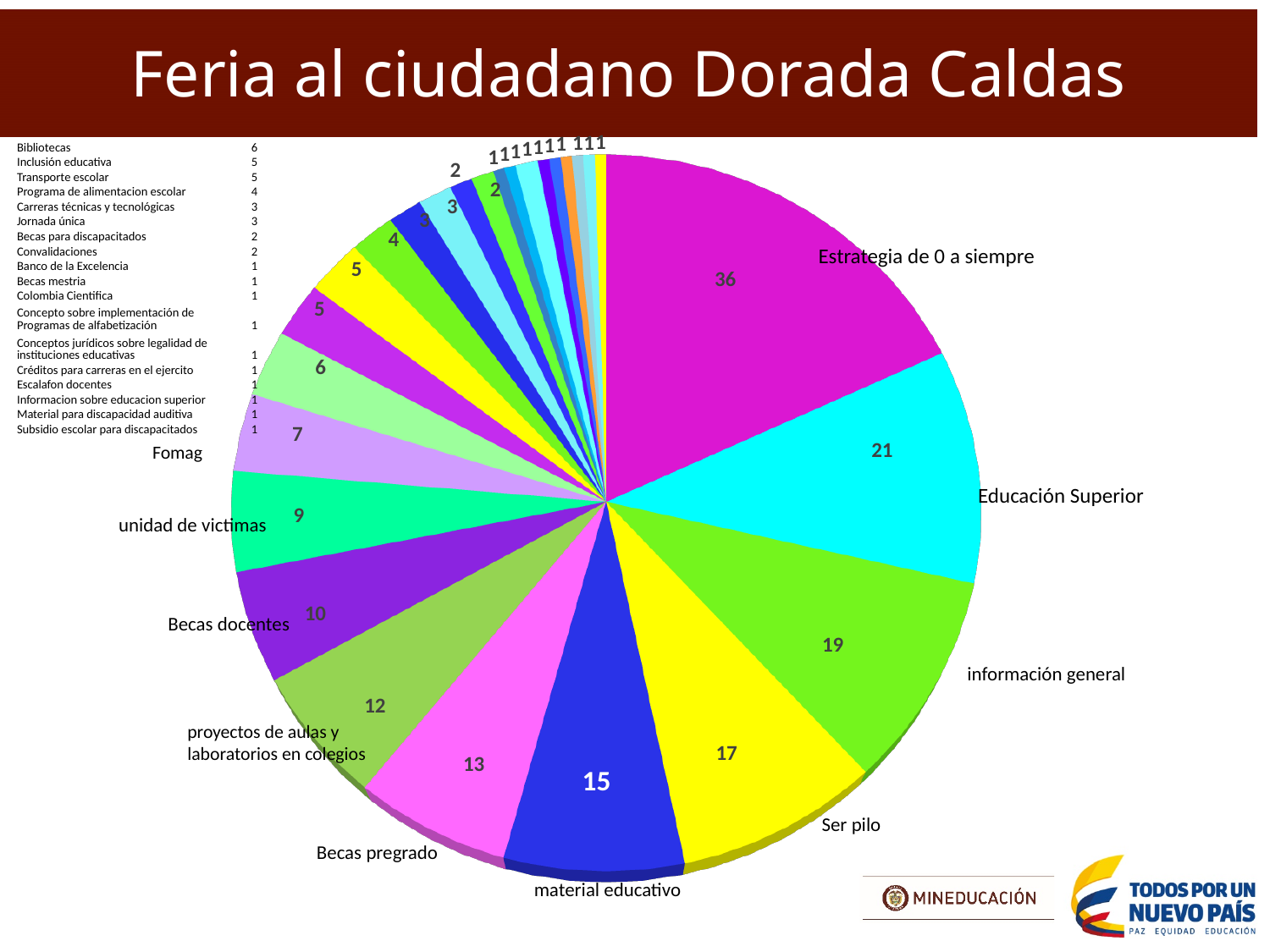
What is the difference between the values for Estrategia de 0 a siempre and Educación Superior? 15 What is the value for Estrategia de 0 a siempre? 36 What is the value for Ser pilo? 17 What kind of chart is shown on the slide? Pie chart What is the value for material educativo? 15 What is the difference between the values for información general and Ser pilo? 2 What is the value for Educación Superior? 21 What is the title of the slide? Feria al ciudadano Dorada Caldas What is the value for Becas pregrado? 13 Which category has the largest slice of the pie? Estrategia de 0 a siempre Which is larger, Becas docentes or unidad de victimas? Becas docentes What is the value for Fomag? 7